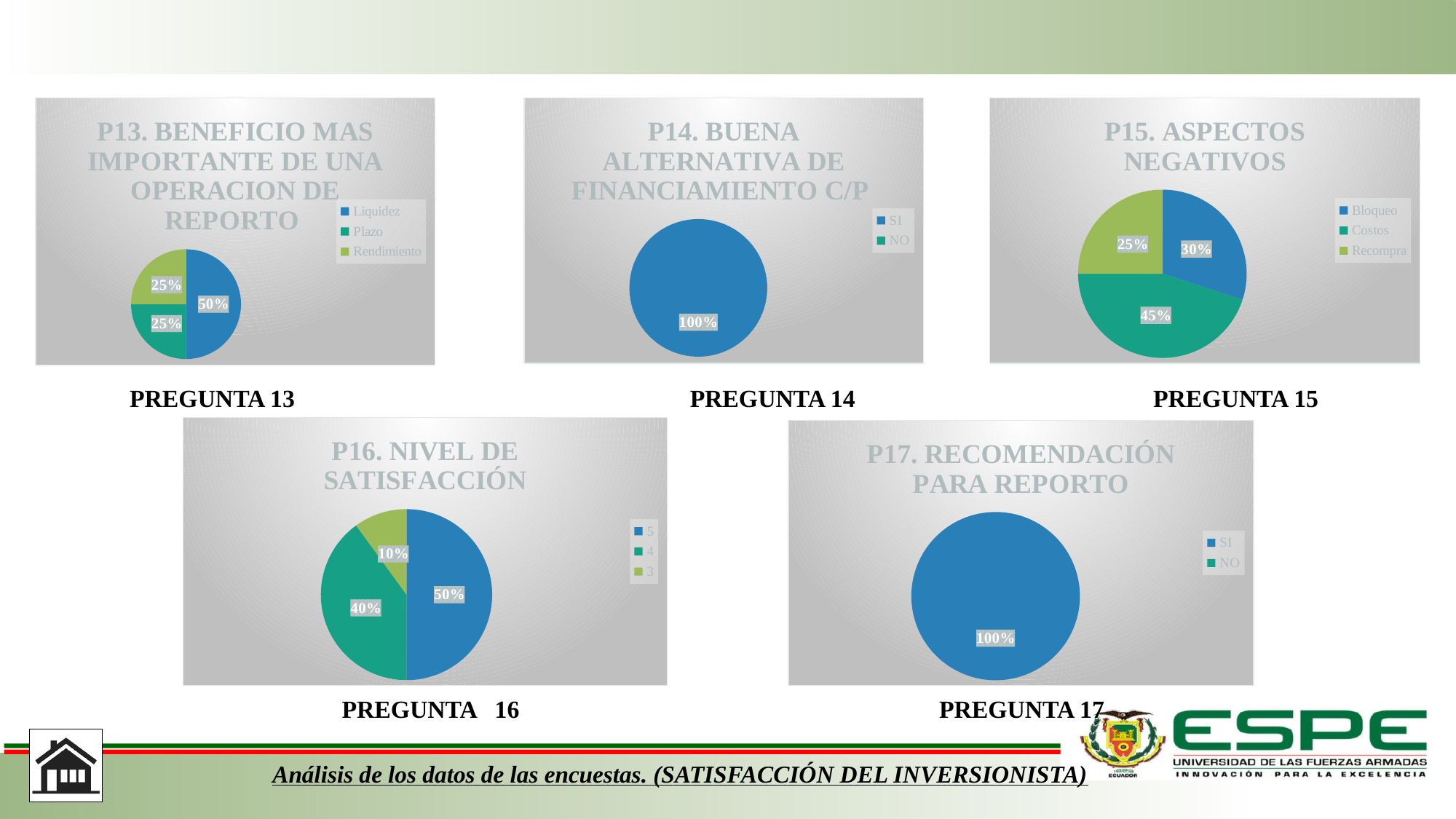
In the chart titled 'P16. NIVEL DE SATISFACCIÓN', what share does the category 4 have? 40% In the chart titled 'P14. BUENA ALTERNATIVA DE FINANCIAMIENTO C/P', what share does SI have? 100% In the chart titled 'P15. ASPECTOS NEGATIVOS', which category has the smallest share? Recompra In the chart titled 'P13. BENEFICIO MAS IMPORTANTE DE UNA OPERACION DE REPORTO', which category has the largest share? Liquidez How many entries does the legend list in the chart titled 'P14. BUENA ALTERNATIVA DE FINANCIAMIENTO C/P'? 2 What type of chart is used for 'P15. ASPECTOS NEGATIVOS'? Pie chart In the chart titled 'P16. NIVEL DE SATISFACCIÓN', which is larger, the share for 5 or the share for 3? 5 In the chart titled 'P15. ASPECTOS NEGATIVOS', what is the difference between the shares of Costos and Bloqueo? 15% In the chart titled 'P15. ASPECTOS NEGATIVOS', what share does Costos have? 45% In the chart titled 'P13. BENEFICIO MAS IMPORTANTE DE UNA OPERACION DE REPORTO', what share does Liquidez have? 50% In the chart titled 'P17. RECOMENDACIÓN PARA REPORTO', what share does SI have? 100% How many categories does the legend list in the chart titled 'P16. NIVEL DE SATISFACCIÓN'? 3